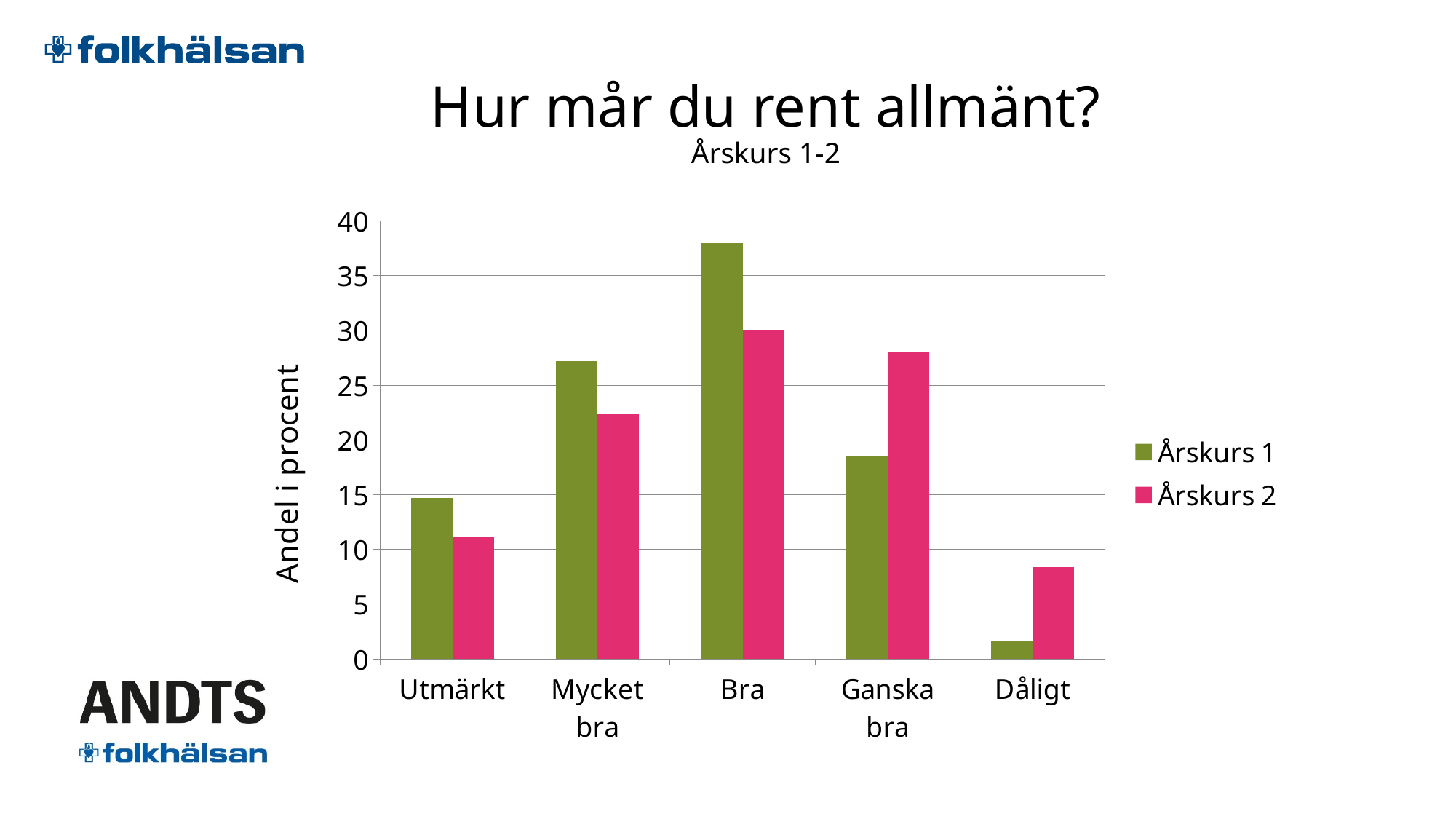
What is the label of the y axis? Andel i procent Is the value for Bra in Årskurs 1 greater or less than 35? greater Which category has the lowest value for Årskurs 2? Dåligt Which category has the lowest value for Årskurs 1? Dåligt How many categories are shown on the x axis? 5 Which category has the highest value for Årskurs 2? Bra What kind of chart is shown on the slide? bar chart Which category has the highest value for Årskurs 1? Bra Is the value for Dåligt in Årskurs 2 greater or less than 10? less How many series does the legend list? 2 For Ganska bra, which series has the larger value, Årskurs 1 or Årskurs 2? Årskurs 2 For Utmärkt, which series has the larger value, Årskurs 1 or Årskurs 2? Årskurs 1